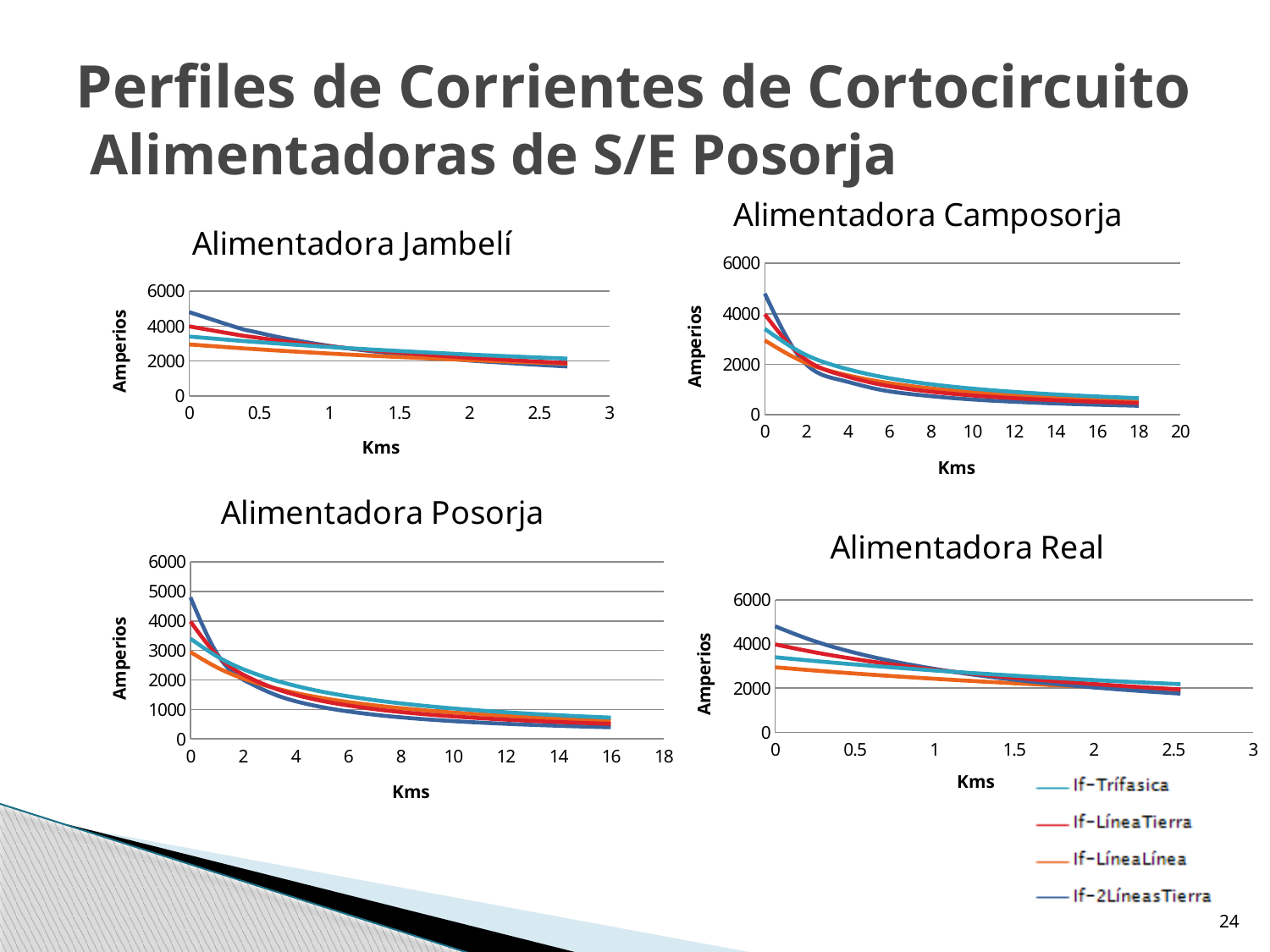
In the 'Alimentadora Camposorja' chart, do the current values rise or fall as the distance in Kms increases? fall In the 'Alimentadora Jambelí' chart, is the value of the If-2LíneasTierra series at 0 Kms greater or less than 4000? greater What is the label of the y axis on the 'Alimentadora Real' chart? Amperios In the 'Alimentadora Posorja' chart, do the values of the If-Trifásica series rise or fall along the x axis? fall How many charts are shown on the slide? 4 In the 'Alimentadora Posorja' chart, which series has the highest value at 0 Kms? If-2LíneasTierra In the 'Alimentadora Jambelí' chart, is the value of the If-LíneaLínea series at 0 Kms greater or less than 4000? less How many series does the legend on the slide list? 4 What is the title of the chart in the top-right position of the slide? Alimentadora Camposorja In the 'Alimentadora Camposorja' chart, is the value of the If-Trifásica series at 18 Kms greater or less than 2000? less What kind of chart is the 'Alimentadora Jambelí' chart? line chart